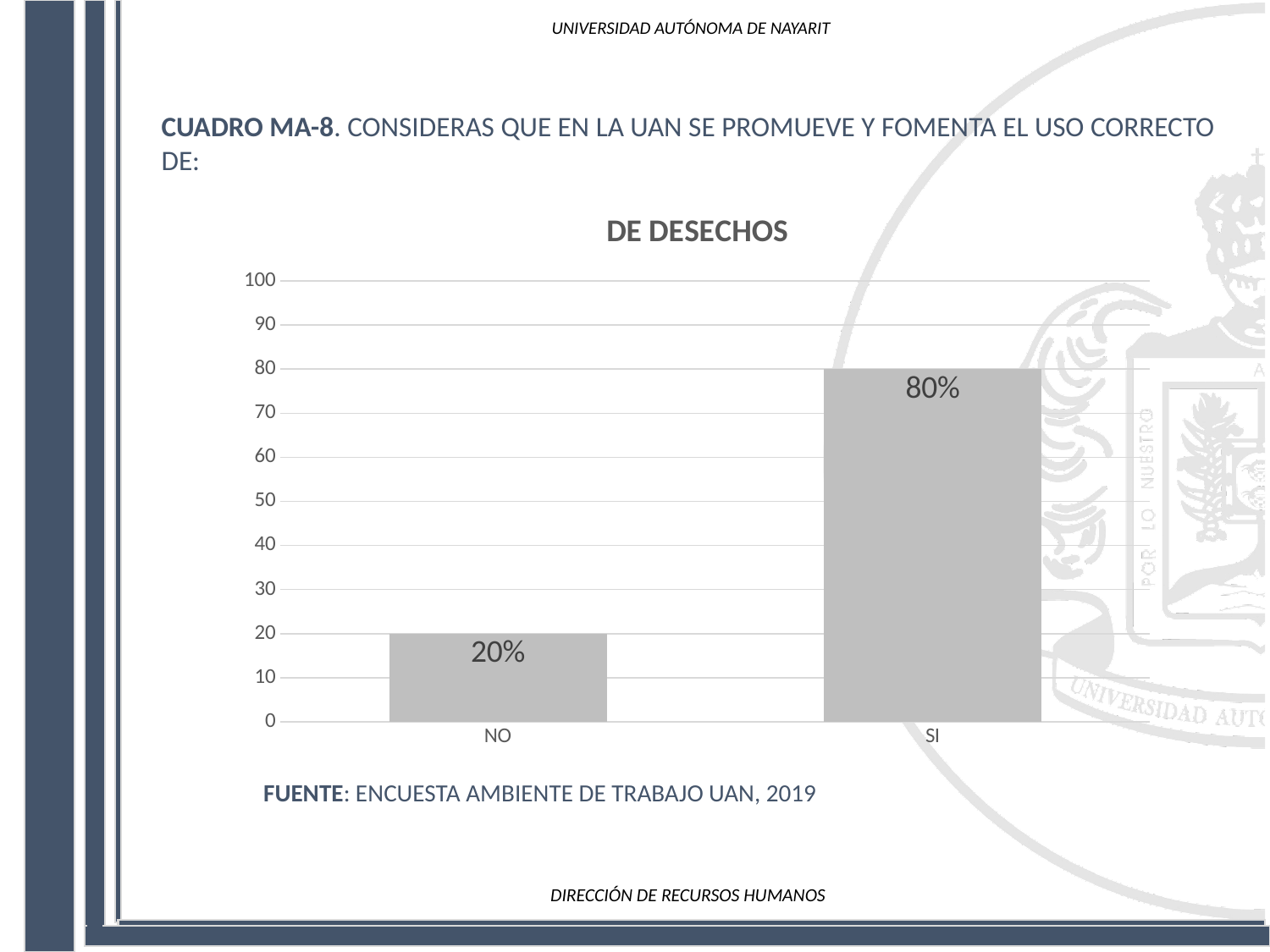
Which category has the highest value? SI Is the value for SI greater or less than 50? greater What is the difference between the values for SI and NO? 60% Which is larger, the value for NO or the value for SI? SI What is the title of the chart? DE DESECHOS What is the value for SI? 80% How many categories are shown on the x axis? 2 What kind of chart is shown on the slide? bar chart Which category has the lowest value? NO What is the value for NO? 20% What is the maximum value shown on the vertical axis? 100 Is the value for NO greater or less than 30? less